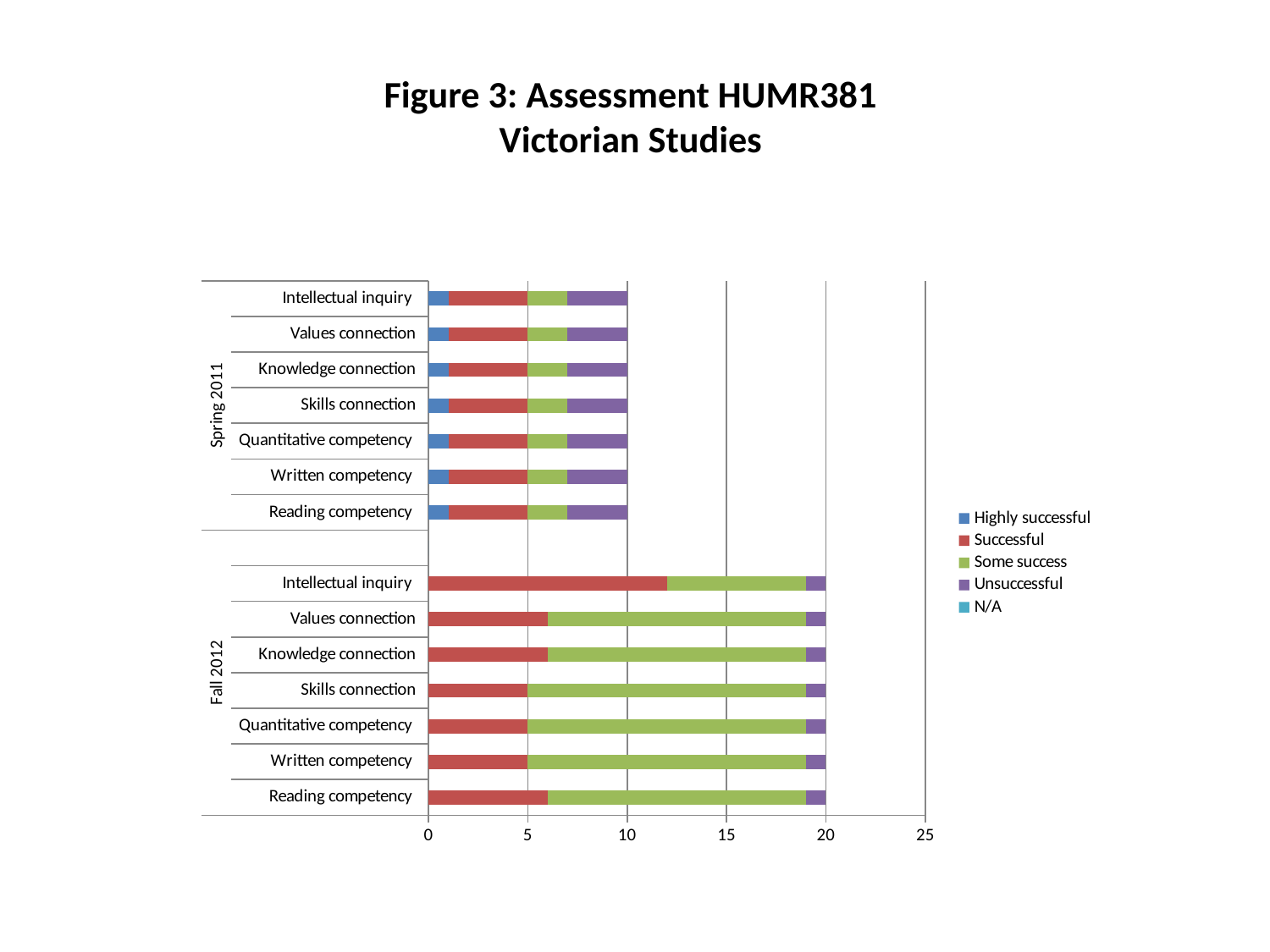
What is the total of the stacked bar for Reading competency in Spring 2011? 10 What kind of chart is shown on the slide? Stacked bar chart How many series does the legend list? 5 Which semester has the larger total bar for Written competency, Spring 2011 or Fall 2012? Fall 2012 How many category bars are plotted in total across both semesters? 14 Is the Successful value for Intellectual inquiry in Fall 2012 greater or less than 10? greater What is the title of the chart? Figure 3: Assessment HUMR381 Victorian Studies Which legend entry is shown in red? Successful What is the total of the stacked bar for Intellectual inquiry in Fall 2012? 20 Is the Some success value for Knowledge connection in Spring 2011 greater or less than 5? less What is the Successful value for Skills connection in Fall 2012? 5 Is the Some success value for Values connection in Fall 2012 greater or less than 10? greater